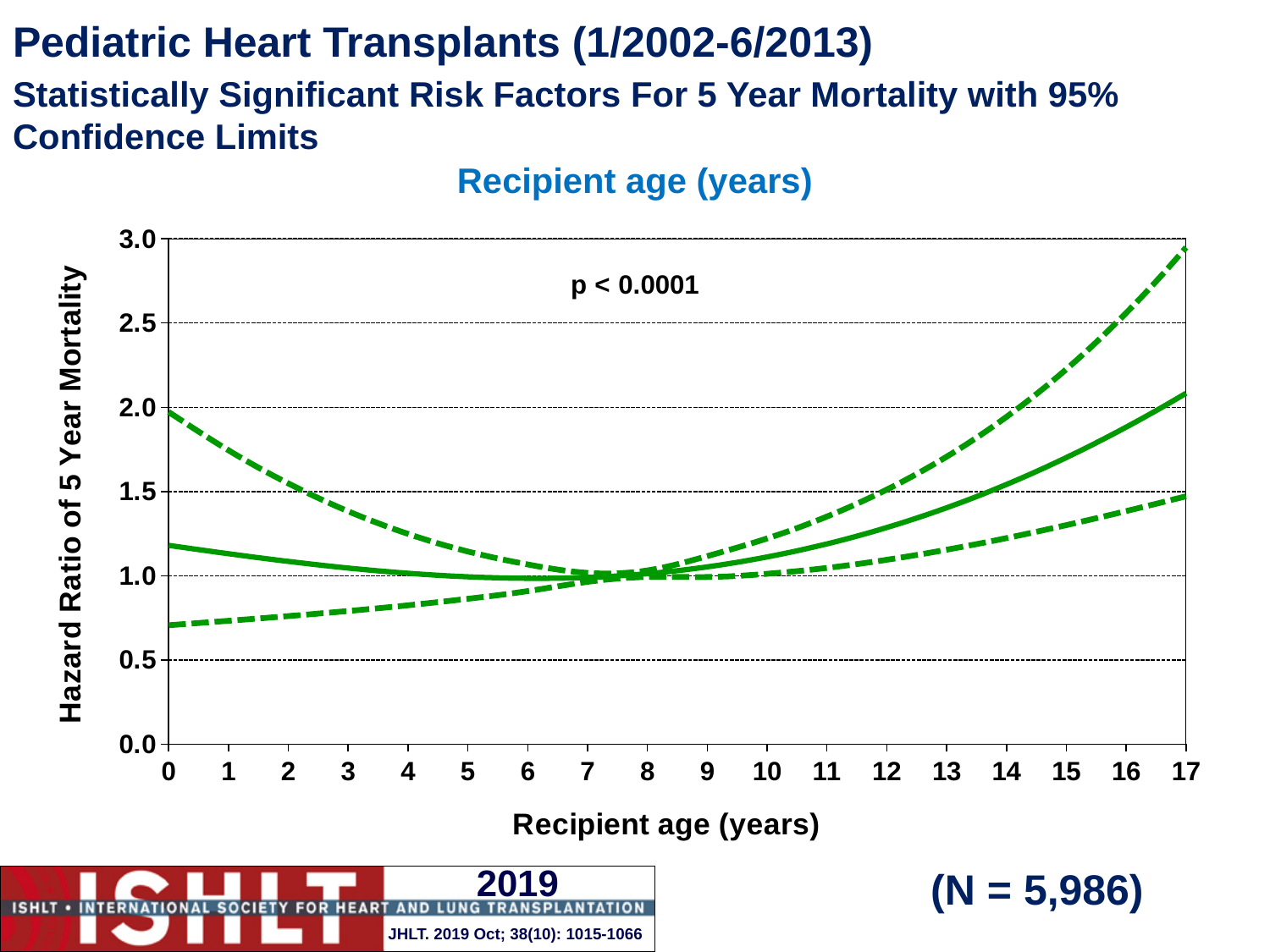
What is the label of the y axis? Hazard Ratio of 5 Year Mortality Does the solid hazard ratio line rise or fall between recipient age 8 and recipient age 17? rise How many tick labels are shown on the x axis? 18 Is the hazard ratio on the solid line at recipient age 17 greater or less than 1.5? greater Is the upper dashed confidence limit at recipient age 0 greater or less than 1.5? greater At which recipient age does the solid hazard ratio line reach its highest value? 17 Is the lower dashed confidence limit at recipient age 0 greater or less than 1.0? less What kind of chart is shown on the slide? line chart How many lines are plotted on the chart? 3 What is the label of the x axis? Recipient age (years)